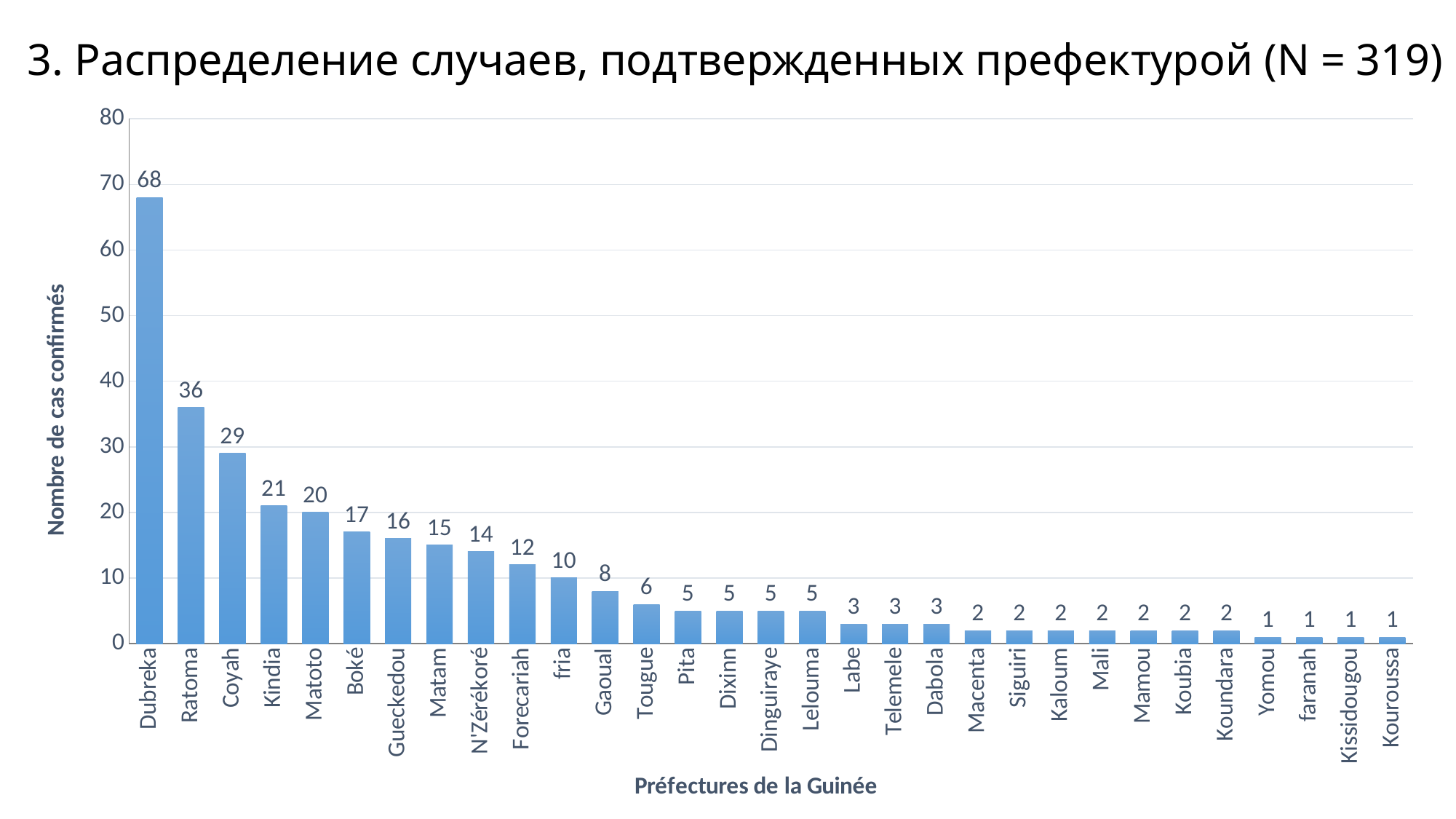
What is the value shown for Kindia? 21 What is the difference between the values for Coyah and Matoto? 9 Which has a larger value, Boké or Gaoual? Boké What is the number of confirmed cases for Dubreka? 68 What type of chart is shown on the slide? Bar chart What is the label of the y axis? Nombre de cas confirmés What is the value shown for Macenta? 2 What is the lowest value shown on the chart? 1 Which prefecture has the highest number of confirmed cases? Dubreka How many prefectures are shown on the x axis? 31 What is the difference between the values for Dubreka and Ratoma? 32 What is the value shown for Forecariah? 12